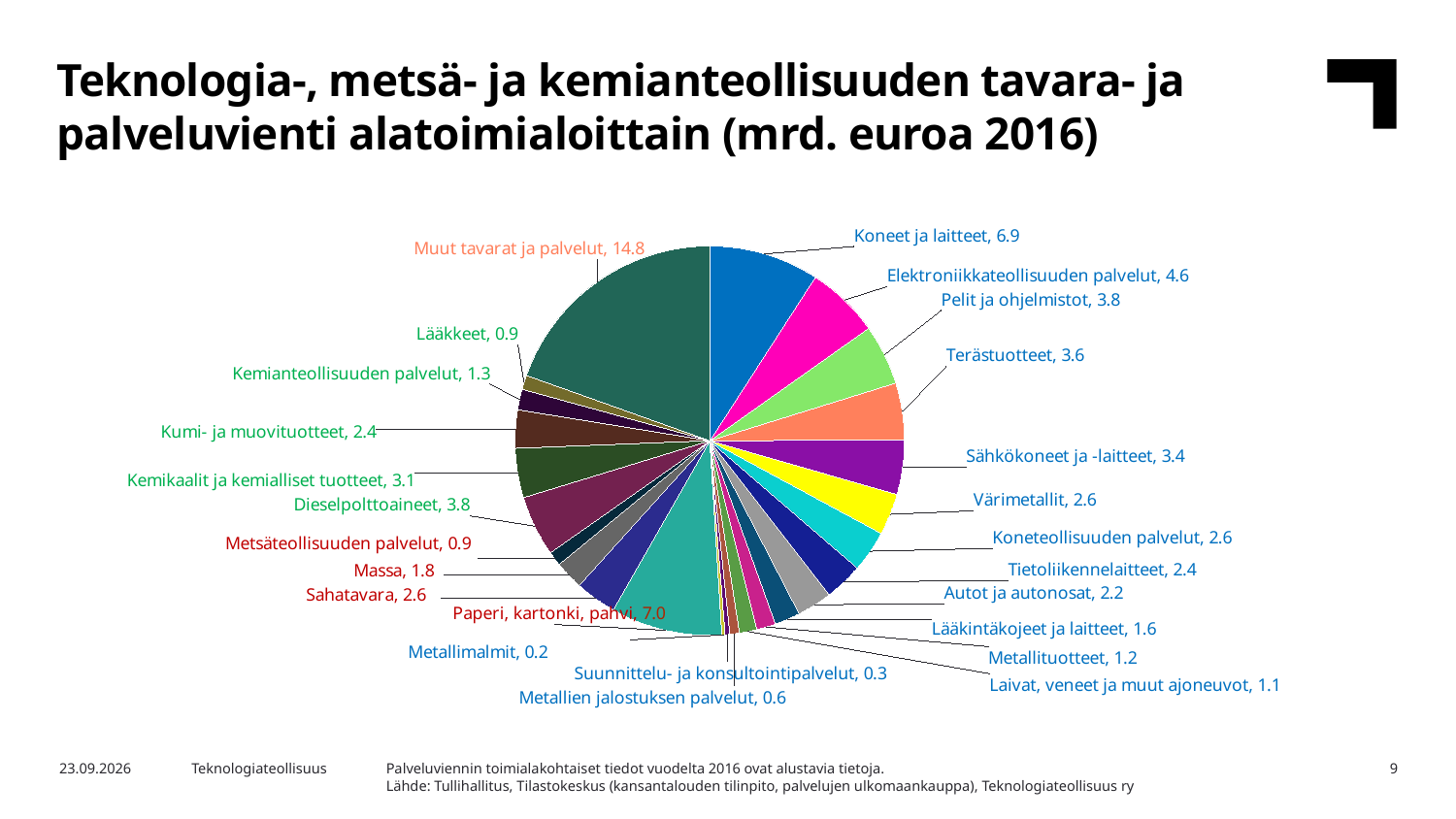
Which is larger, Terästuotteet or Sähkökoneet ja -laitteet? Terästuotteet What type of chart is shown on the slide? Pie chart What is the value for Laivat, veneet ja muut ajoneuvot? 1.1 What is the difference between Muut tavarat ja palvelut and Koneet ja laitteet? 7.9 What is the difference between Elektroniikkateollisuuden palvelut and Pelit ja ohjelmistot? 0.8 What is the value for Paperi, kartonki, pahvi? 7.0 What is the value for Koneet ja laitteet? 6.9 Which is larger, Kemikaalit ja kemialliset tuotteet or Kumi- ja muovituotteet? Kemikaalit ja kemialliset tuotteet Which category has the smallest slice of the pie? Metallimalmit What is the value for Dieselpolttoaineet? 3.8 Which category has the largest slice of the pie? Muut tavarat ja palvelut In what unit are the values in the chart expressed, according to the title? mrd. euroa